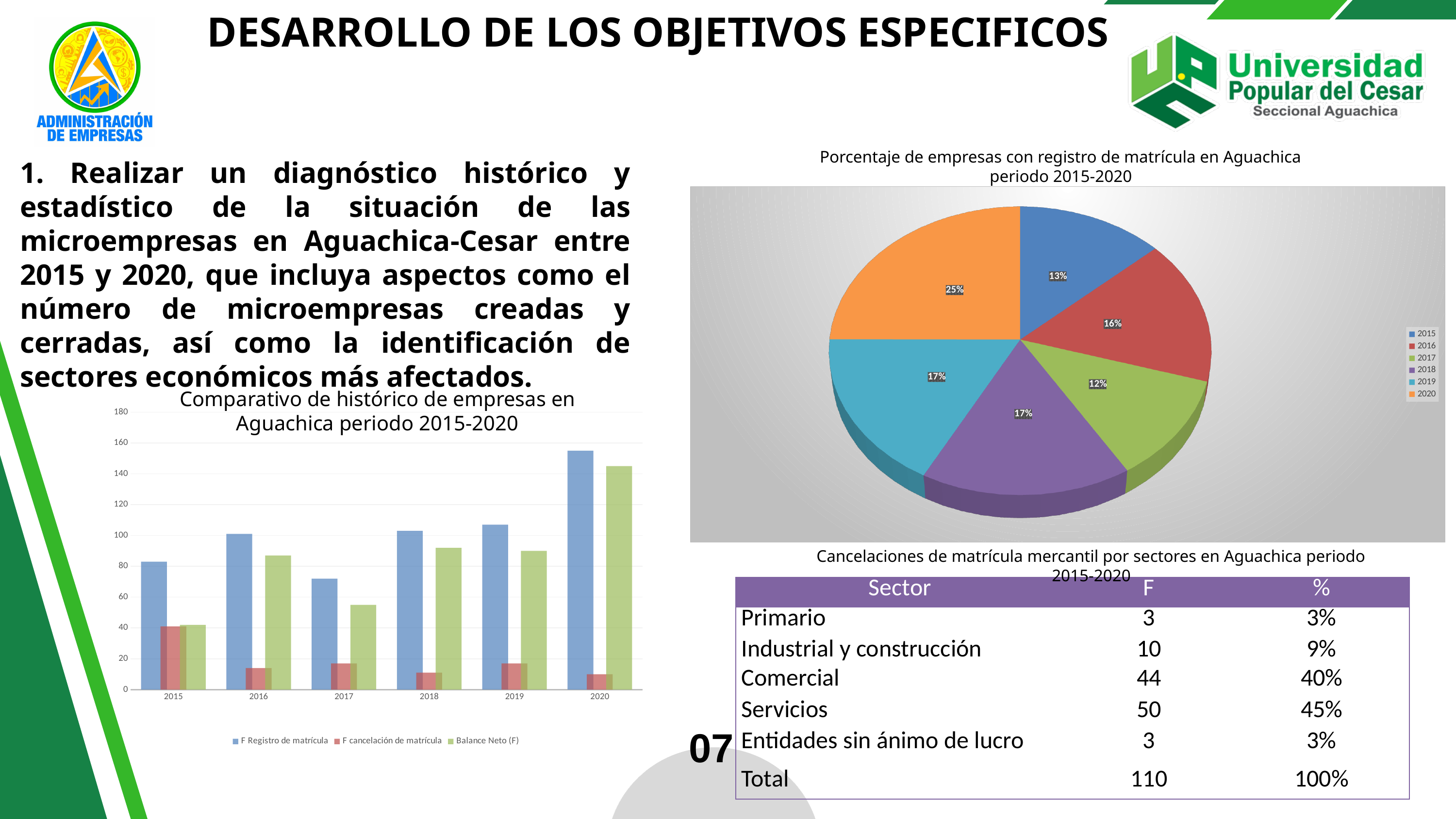
What kind of chart is the 'Comparativo de histórico de empresas en Aguachica periodo 2015-2020' chart? bar chart In the 'Comparativo de histórico de empresas' bar chart, which year has the highest value for F Registro de matrícula? 2020 In the pie chart 'Porcentaje de empresas con registro de matrícula', what share does 2020 have? 25% In the 'Comparativo de histórico de empresas' bar chart, is the value for F cancelación de matrícula in 2016 greater or less than 20? less How many slices does the pie chart 'Porcentaje de empresas con registro de matrícula' have? 6 How many series does the legend of the 'Comparativo de histórico de empresas' bar chart list? 3 In the 'Comparativo de histórico de empresas' bar chart, is the value for F Registro de matrícula in 2020 greater or less than 140? greater In the pie chart 'Porcentaje de empresas con registro de matrícula', which year has the largest slice? 2020 In the pie chart 'Porcentaje de empresas con registro de matrícula', what is the difference between the 2020 share and the 2015 share? 12% In the pie chart 'Porcentaje de empresas con registro de matrícula', which year has the smallest slice? 2017 What kind of chart is the 'Porcentaje de empresas con registro de matrícula en Aguachica periodo 2015-2020' chart? pie chart In the pie chart 'Porcentaje de empresas con registro de matrícula', what share does 2017 have? 12%